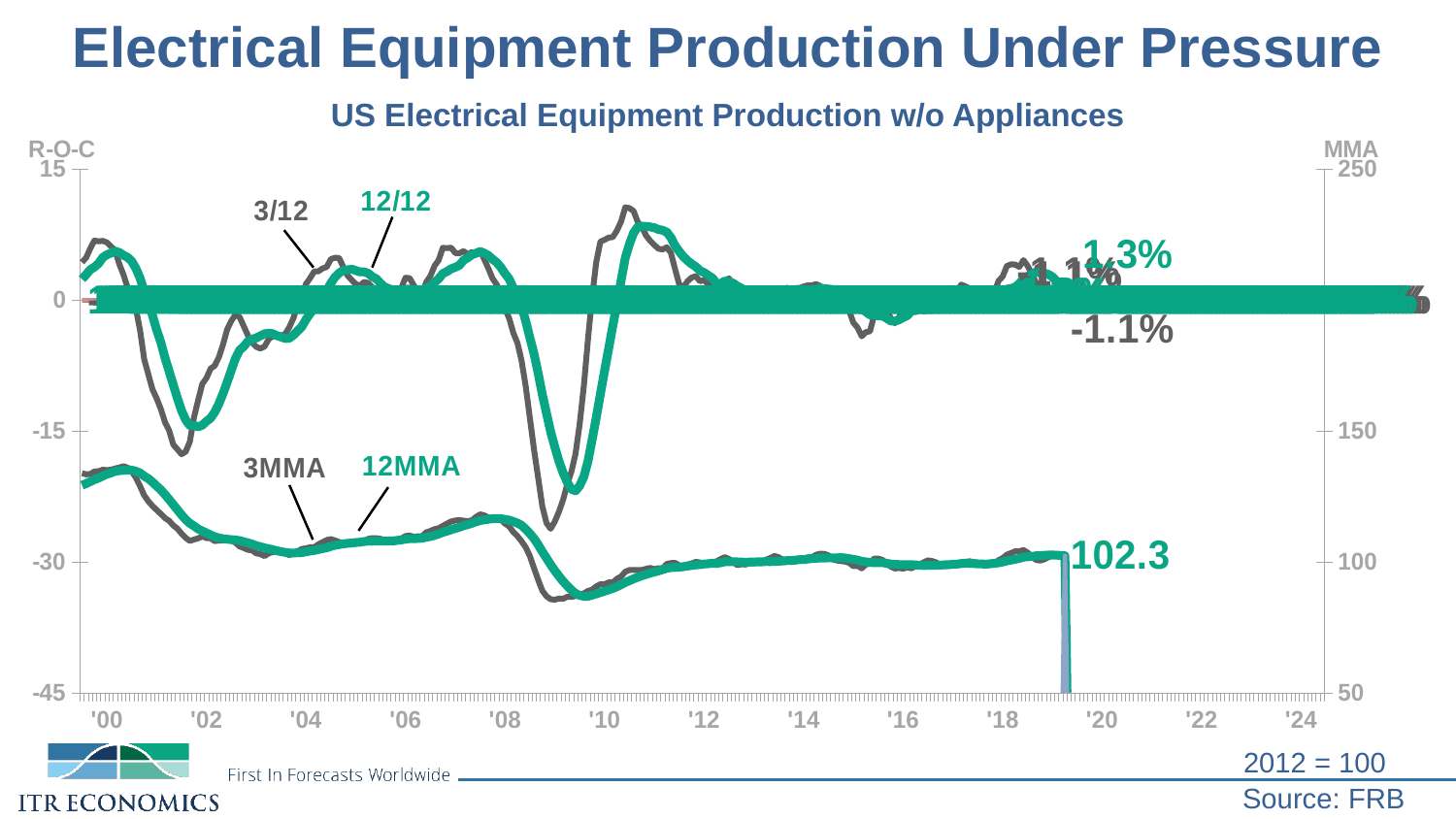
What is the source cited for the chart data? FRB What kind of chart is shown on the slide? line chart Is the 12MMA value around 2009 greater or less than 100 on the right axis? less Which is larger at the latest labeled point, the 12/12 value or the 3/12 value? 12/12 What is the latest labeled value of the 12MMA series? 102.3 What is the title of the chart? US Electrical Equipment Production w/o Appliances What is the latest labeled value of the 12/12 rate-of-change series? 1.3% Is the 12/12 value at its 2009 trough greater or less than -15 on the left axis? less What is the difference between the latest labeled 12/12 value (1.3%) and the latest labeled 3/12 value (-1.1%)? 2.4 percentage points Is the latest 12MMA value greater or less than 100? greater How many series are labeled on the chart? 4 What is the latest labeled value of the 3/12 rate-of-change series? -1.1%